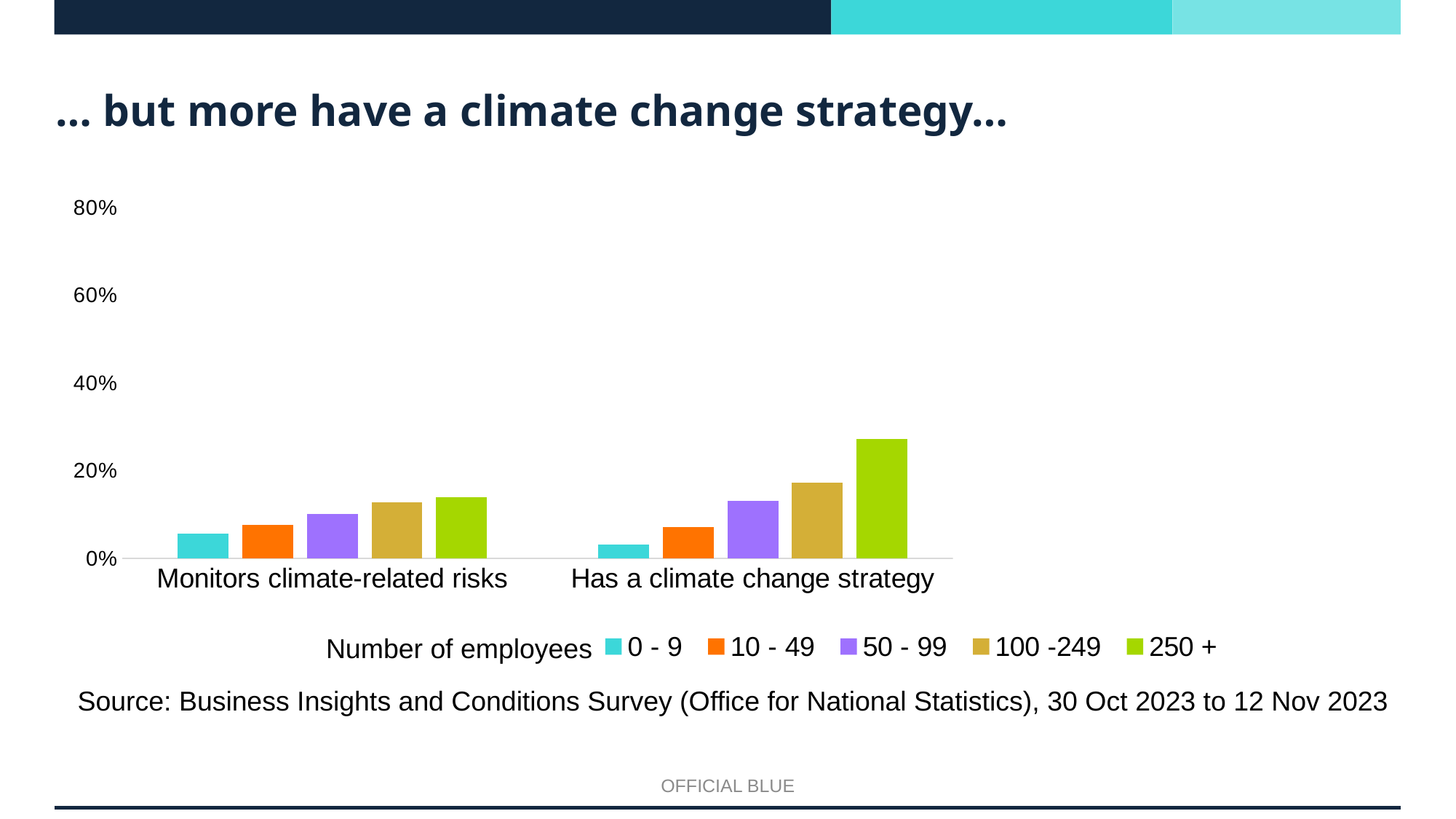
Within 'Has a climate change strategy', do the values rise or fall as the number of employees increases? rise What kind of chart is shown on the slide? bar chart Which employee-size group has the highest value for 'Has a climate change strategy'? 250 + How many categories are shown on the x axis? 2 Which employee-size group has the lowest value for 'Has a climate change strategy'? 0 - 9 For the 250 + group, which is larger: 'Monitors climate-related risks' or 'Has a climate change strategy'? Has a climate change strategy Is the value for 250 + under 'Has a climate change strategy' greater or less than 20%? greater What is the title of the legend? Number of employees How many series does the legend list? 5 Is the value for 0 - 9 under 'Has a climate change strategy' greater or less than 20%? less Is the value for 250 + under 'Monitors climate-related risks' greater or less than 20%? less Which employee-size group has the lowest value for 'Monitors climate-related risks'? 0 - 9